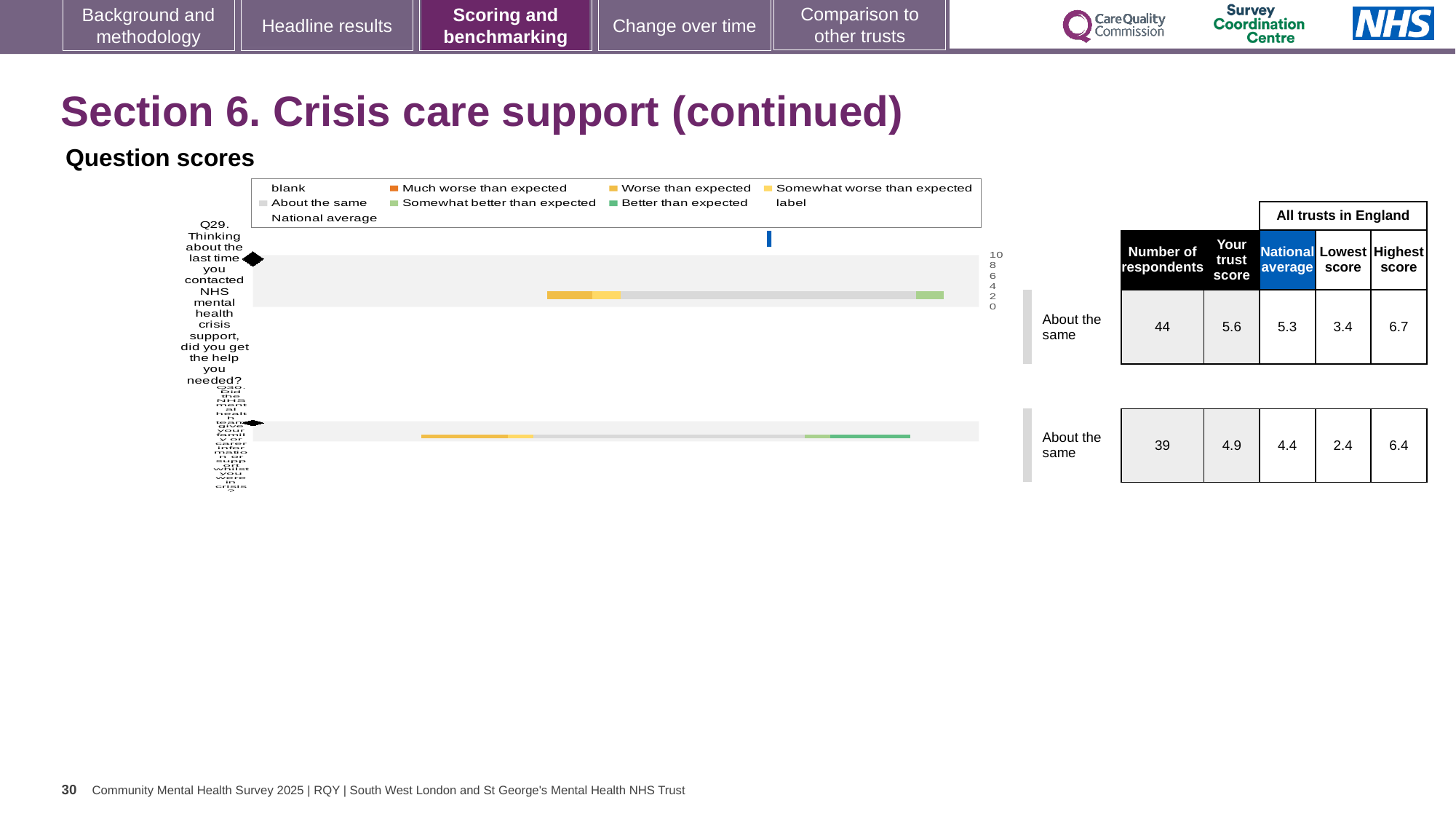
How many entries does the legend of the question scores chart list? 9 What is the national average for Q29? 5.3 How many questions (rows) are plotted in the question scores chart? 2 What is the highest score among all trusts in England for Q29? 6.7 Which is larger for Q30, the trust score or the national average? trust score What benchmark category is shown for Q29 in the question scores chart? About the same What is the trust score for Q29 (Thinking about the last time you contacted NHS mental health crisis support, did you get the help you needed?)? 5.6 What is the trust score for the second question (Q30)? 4.9 What is the lowest score among all trusts in England for Q30? 2.4 How many respondents answered Q29? 44 What is the difference between the trust score and the national average for Q30? 0.5 What kind of chart is used to show the question scores on this slide? bar chart